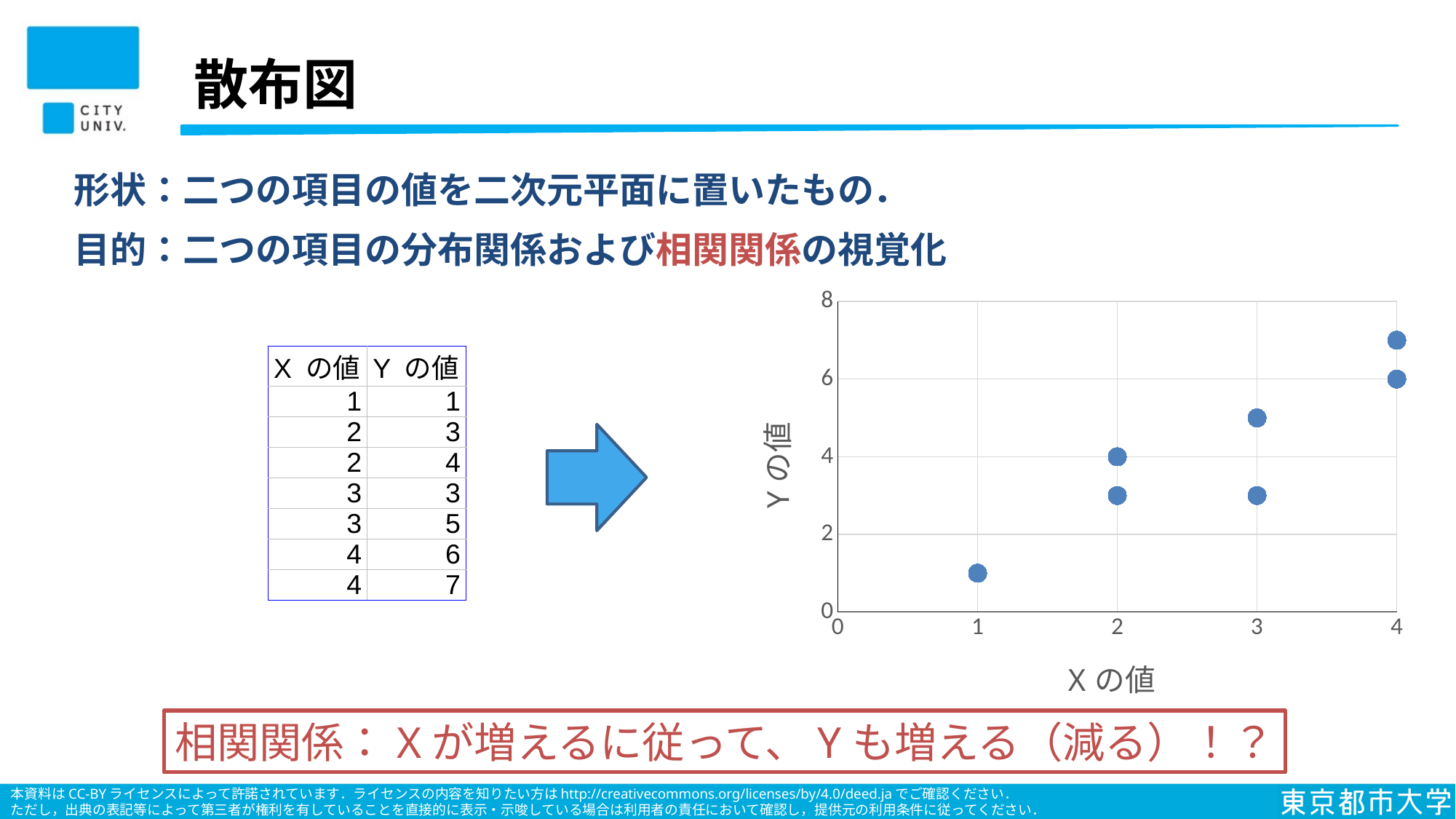
What is the difference between the two Y values plotted at X = 4? 1 How many data points are plotted in the scatter plot? 7 What is the label on the horizontal axis of the chart? X の値 Are the Y values of the points at X = 4 greater or less than 4? greater At which X value does the point with the highest Y value appear? 4 Do the Y values generally rise or fall as X increases? rise What kind of chart is shown on the slide? scatter plot What is the lowest Y value plotted in the chart? 1 What is the Y value of the point plotted at X = 1? 1 What are the two Y values plotted at X = 2? 3 and 4 What is the highest Y value plotted in the chart? 7 Is the higher point at X = 3 larger or smaller than the lower point at X = 4? smaller